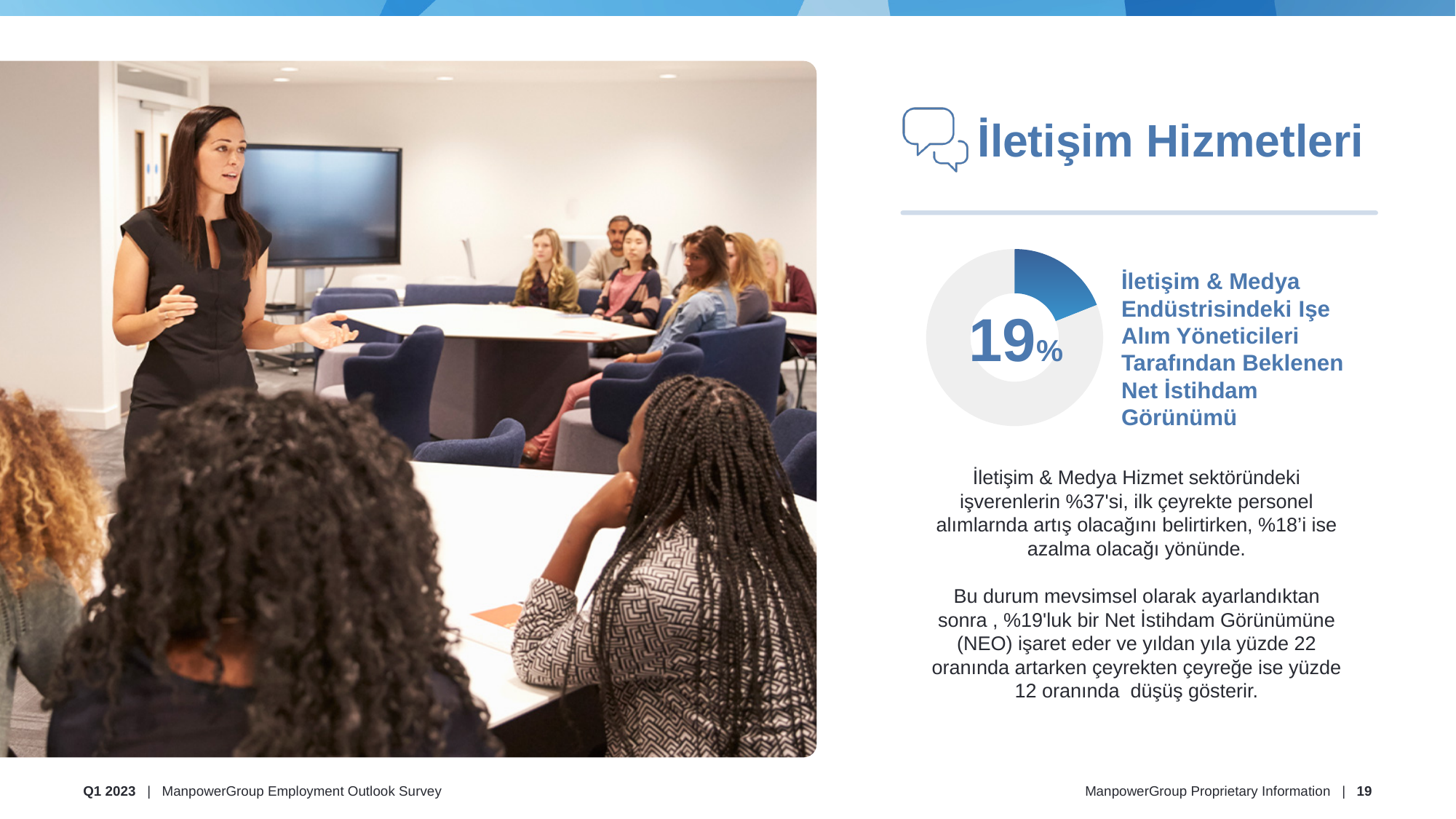
What colour is the highlighted segment of the donut chart? Blue Is the highlighted segment of the donut chart greater or less than half of the whole? less According to the label next to the donut chart, what does the 19% figure represent? İletişim & Medya Endüstrisindeki İşe Alım Yöneticileri Tarafından Beklenen Net İstihdam Görünümü What value is printed in the centre of the donut chart? 19% What share of the donut chart does the highlighted blue segment represent? 19% What kind of chart is shown on the slide? Donut (pie) chart